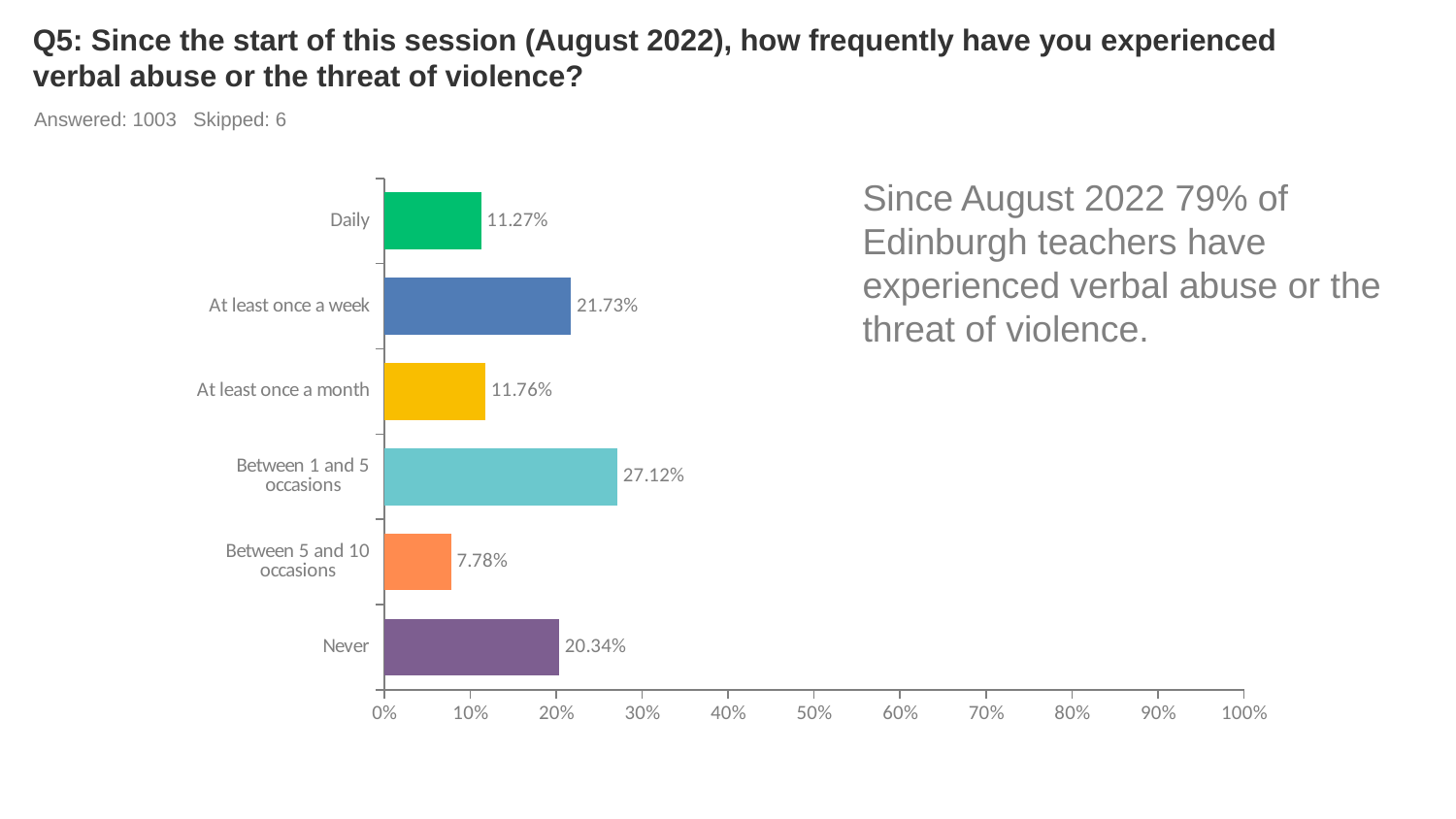
How many respondents answered the question? 1003 Which category has the highest value? Between 1 and 5 occasions Which is larger, "At least once a week" or "Never"? At least once a week How many categories are shown in the chart? 6 What is the value for "At least once a week"? 21.73% What is the difference between "Between 1 and 5 occasions" and "Between 5 and 10 occasions"? 19.34% What kind of chart is shown on the slide? bar chart Is the value for "At least once a month" greater or less than 20%? less What percentage of respondents answered "Never"? 20.34% What is the highest value shown on the x axis? 100% Which category has the lowest value? Between 5 and 10 occasions What percentage of respondents answered "Daily"? 11.27%